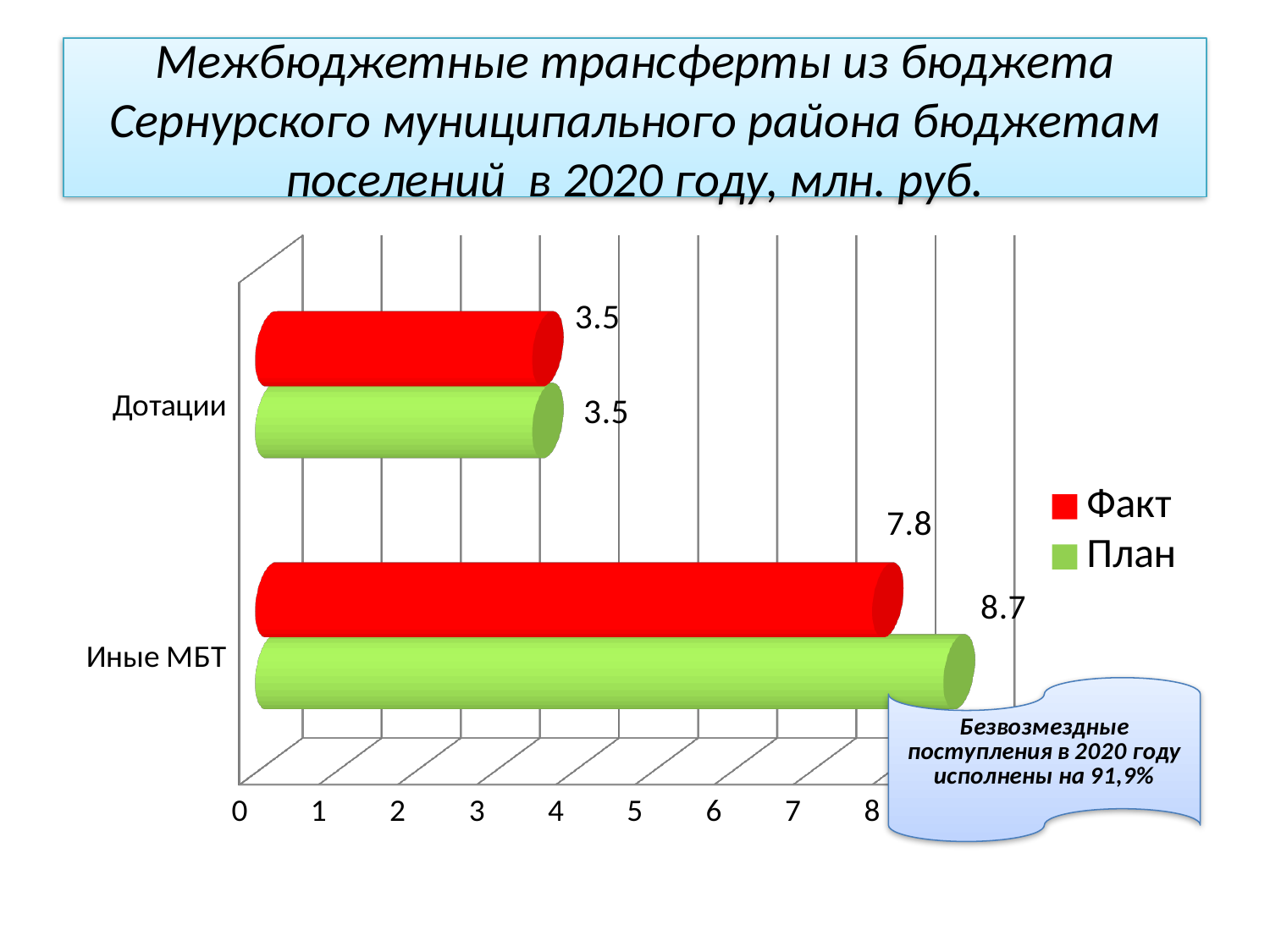
What kind of chart is shown on the slide? bar chart What is the difference between the План and Факт values for Иные МБТ? 0.9 What is the План value for Иные МБТ? 8.7 What is the Факт value for Дотации? 3.5 Is the Факт value for Иные МБТ greater or less than 5? greater What is the План value for Дотации? 3.5 For Иные МБТ, which is larger: Факт or План? План How many categories are shown on the chart? 2 What is the Факт value for Иные МБТ? 7.8 How many series does the legend list? 2 Which category has the lowest Факт value? Дотации Which category has the highest План value? Иные МБТ